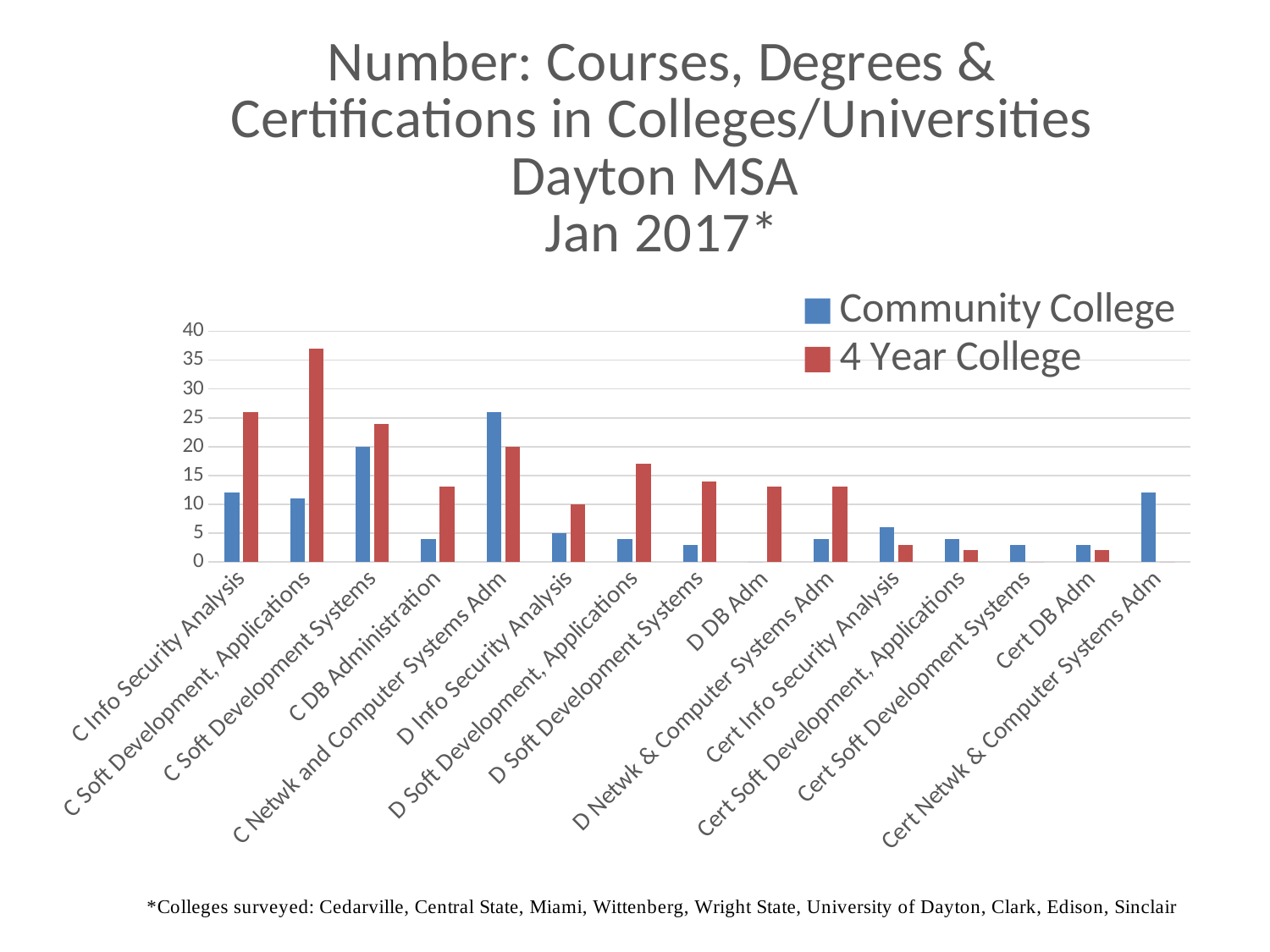
What kind of chart is shown on the slide? bar chart Is the 4 Year College value for D Soft Development, Applications greater or less than 15? greater For C Info Security Analysis, which is larger: the Community College value or the 4 Year College value? 4 Year College Is the 4 Year College value for C Soft Development, Applications greater or less than 30? greater How many series does the legend list? 2 Which colour represents the 4 Year College series? red For C Netwk and Computer Systems Adm, which is larger: the Community College value or the 4 Year College value? Community College How many categories are shown along the x axis? 15 Which category has the highest Community College value? C Netwk and Computer Systems Adm Is the Community College value for Cert Netwk & Computer Systems Adm greater or less than 10? greater Which category has the highest 4 Year College value? C Soft Development, Applications